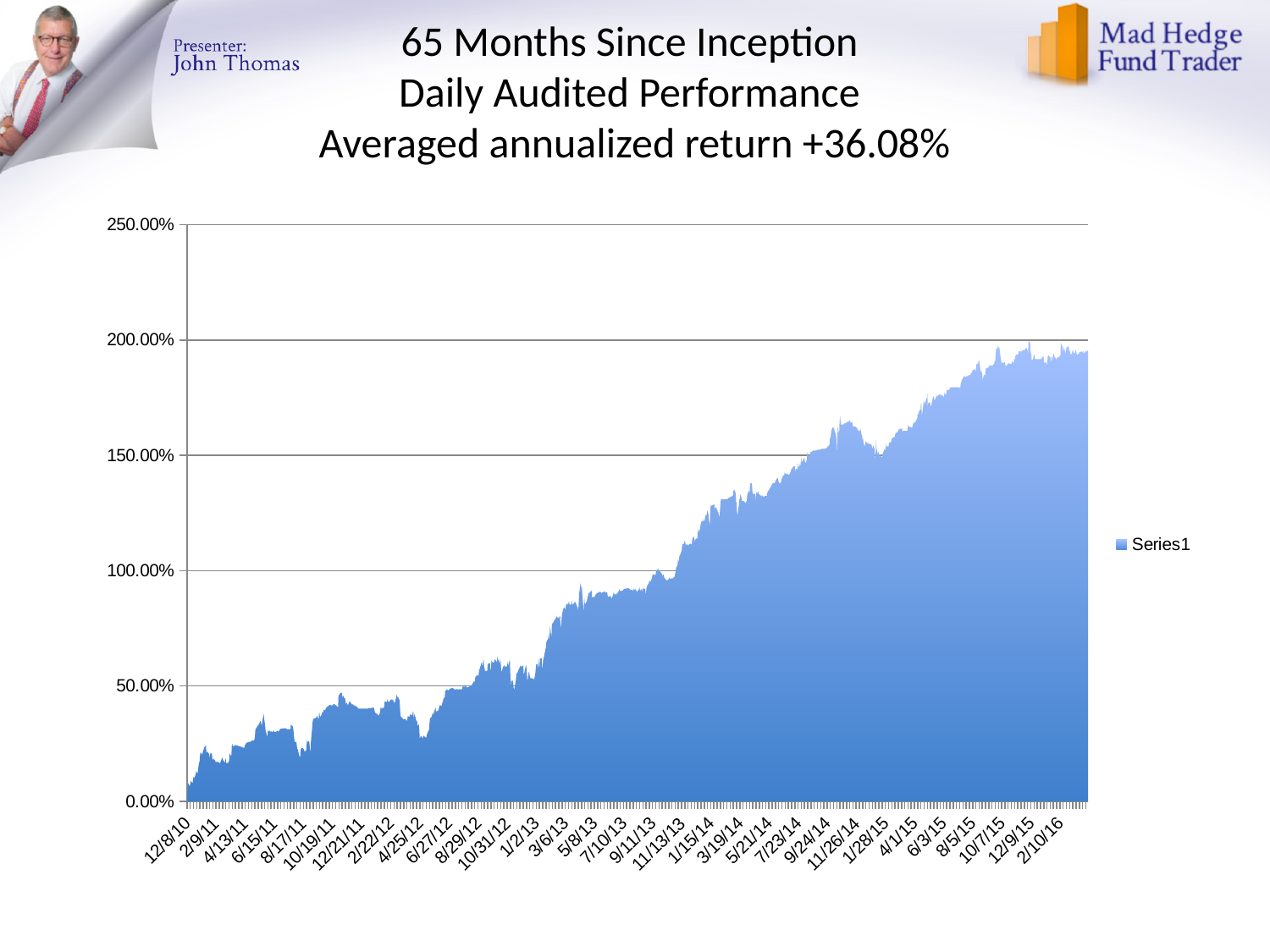
Is the value at 2/10/16 greater or less than 150.00%? greater Is the value at 3/6/13 greater or less than 50.00%? greater Is the value at 11/26/14 greater or less than 200.00%? less What is the name of the series shown in the legend? Series1 How many series does the legend list? 1 Do the values generally rise or fall from 12/8/10 to 2/10/16? rise What kind of chart is shown on the slide? area chart What averaged annualized return is stated in the chart title? +36.08%